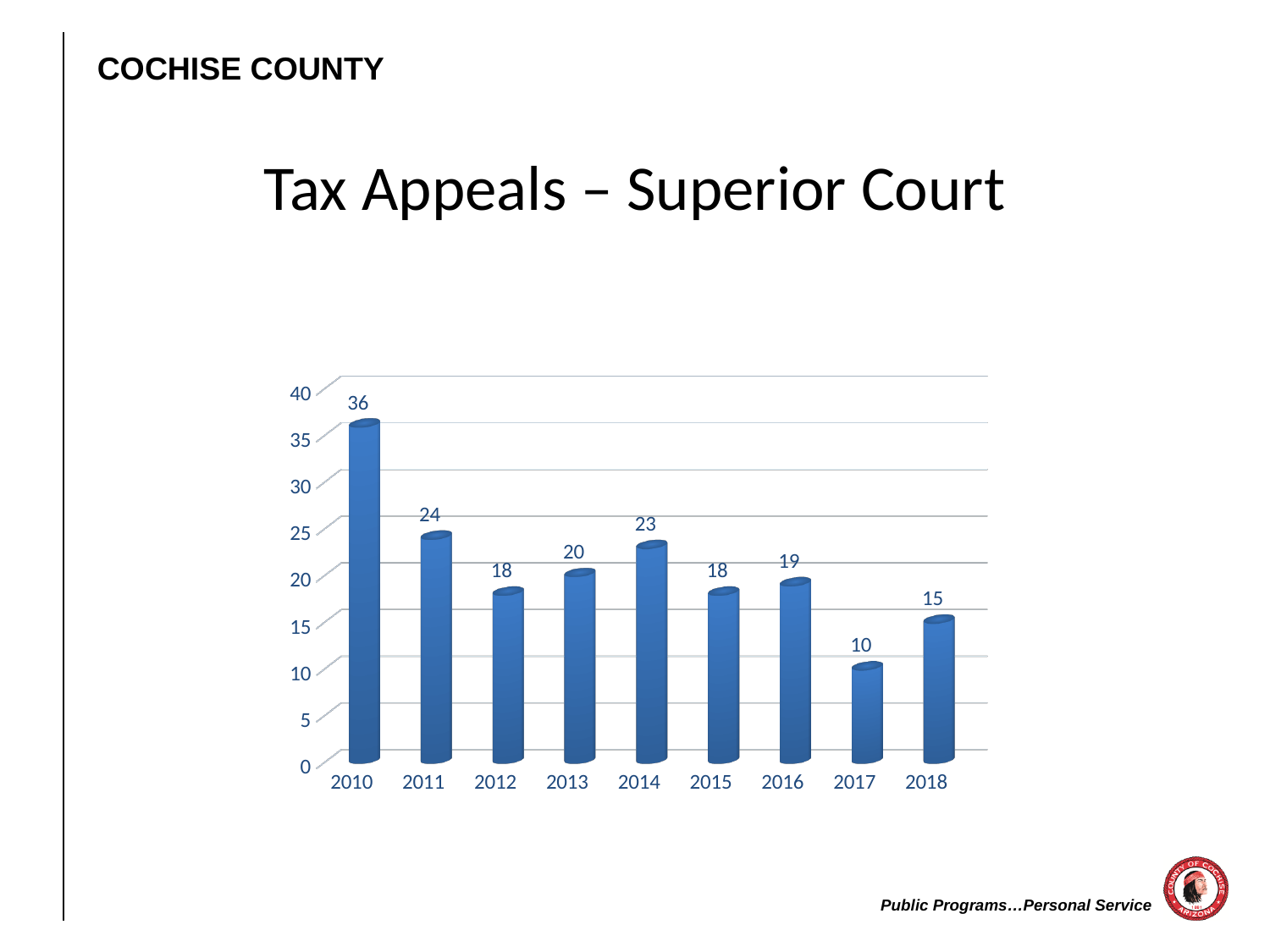
Which year has the highest value? 2010 Which is larger, the value for 2013 or the value for 2016? 2013 What kind of chart is shown on the slide? bar chart What is the difference between the values for 2010 and 2011? 12 What is the value for 2014? 23 Which year has the lowest value? 2017 What is the value for 2010? 36 How many years are shown on the x axis? 9 What is the value for 2017? 10 What is the difference between the values for 2018 and 2017? 5 Is the value for 2012 greater or less than 20? less What is the title of the slide's chart? Tax Appeals – Superior Court